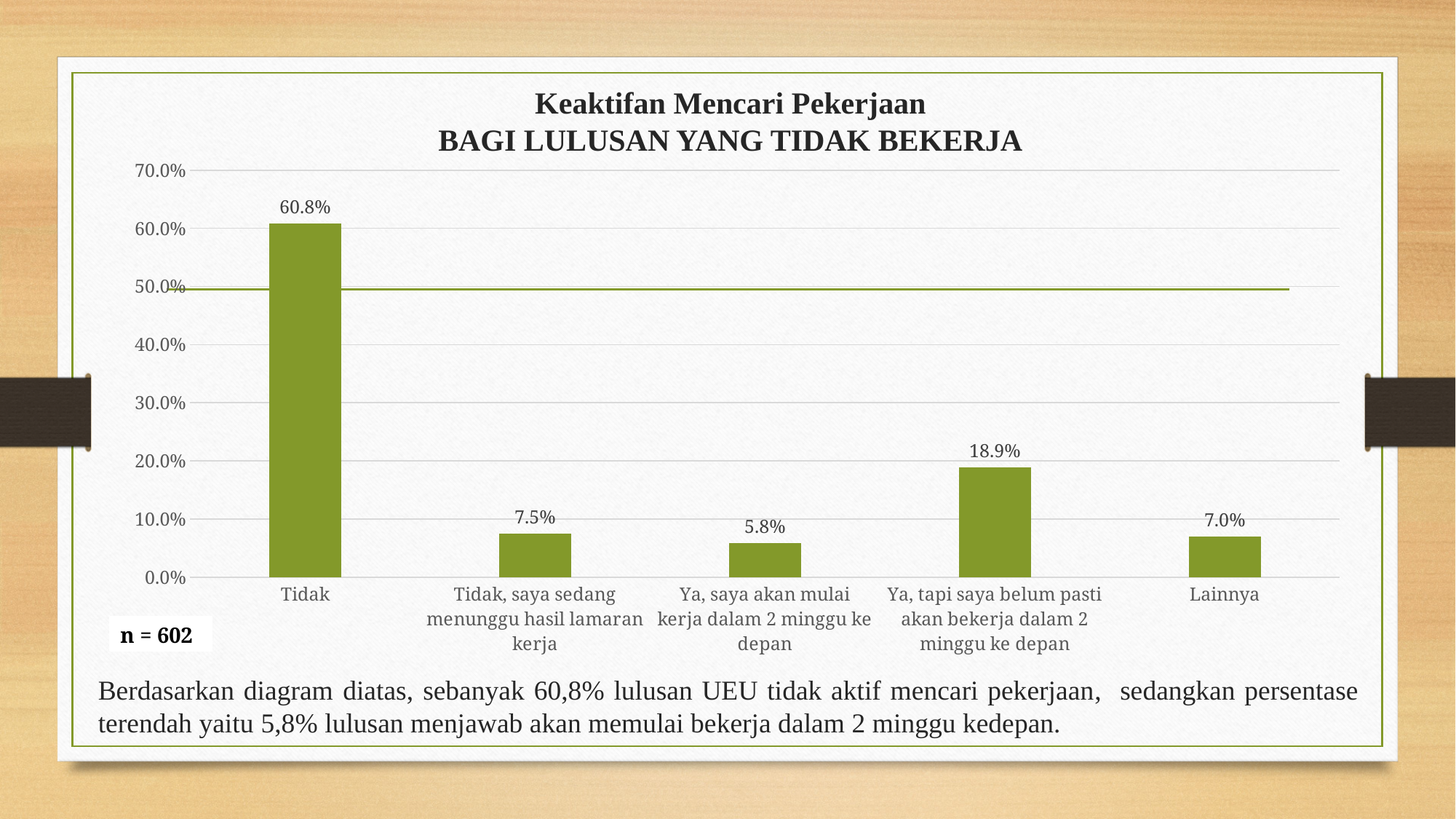
What is the value for "Tidak, saya sedang menunggu hasil lamaran kerja"? 7.5% How many categories are shown on the x axis? 5 What is the difference between the values for "Tidak" and "Ya, tapi saya belum pasti akan bekerja dalam 2 minggu ke depan"? 41.9% Is the value for "Tidak" greater or less than 50.0%? greater What is the value for "Tidak"? 60.8% What is the value for "Lainnya"? 7.0% What is the value for "Ya, tapi saya belum pasti akan bekerja dalam 2 minggu ke depan"? 18.9% Which category has the lowest value? Ya, saya akan mulai kerja dalam 2 minggu ke depan What sample size (n) is stated on the slide? n = 602 Which is larger, the value for "Tidak, saya sedang menunggu hasil lamaran kerja" or the value for "Lainnya"? Tidak, saya sedang menunggu hasil lamaran kerja What kind of chart is shown on the slide? bar chart Which category has the highest value? Tidak